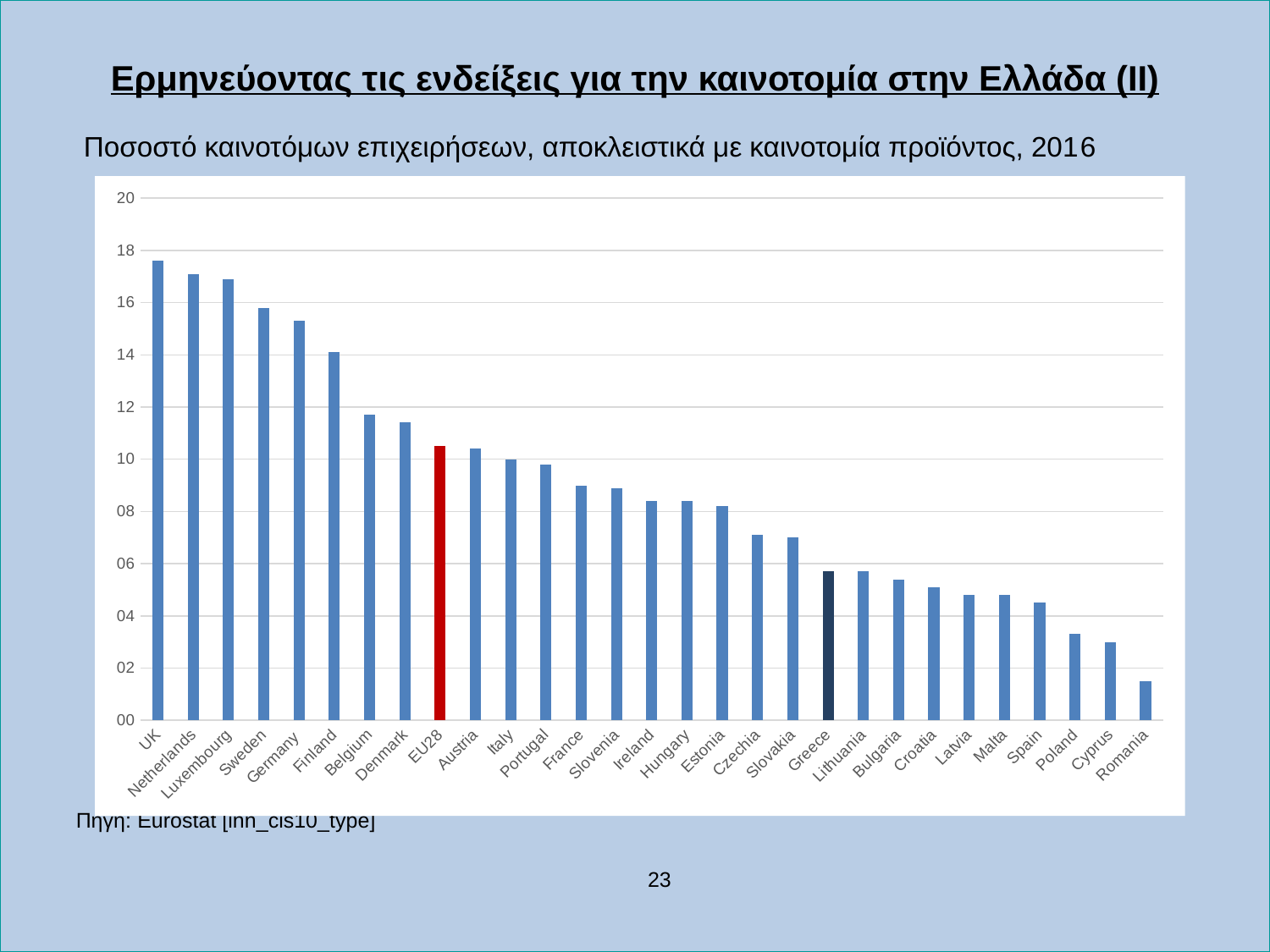
Is the value for Belgium greater or less than 10? greater Is the value for Greece greater or less than 8? less Which country has the highest value in the chart? UK How many bars (categories) are plotted in the chart? 29 Is the value for Romania greater or less than 2? less Which country has the lowest value in the chart? Romania What colour is the bar for EU28? red Which has the larger value, Germany or Belgium? Germany What kind of chart is shown on the slide? bar chart Do the values rise or fall moving from left to right along the x axis? fall Which has the larger value, EU28 or Greece? EU28